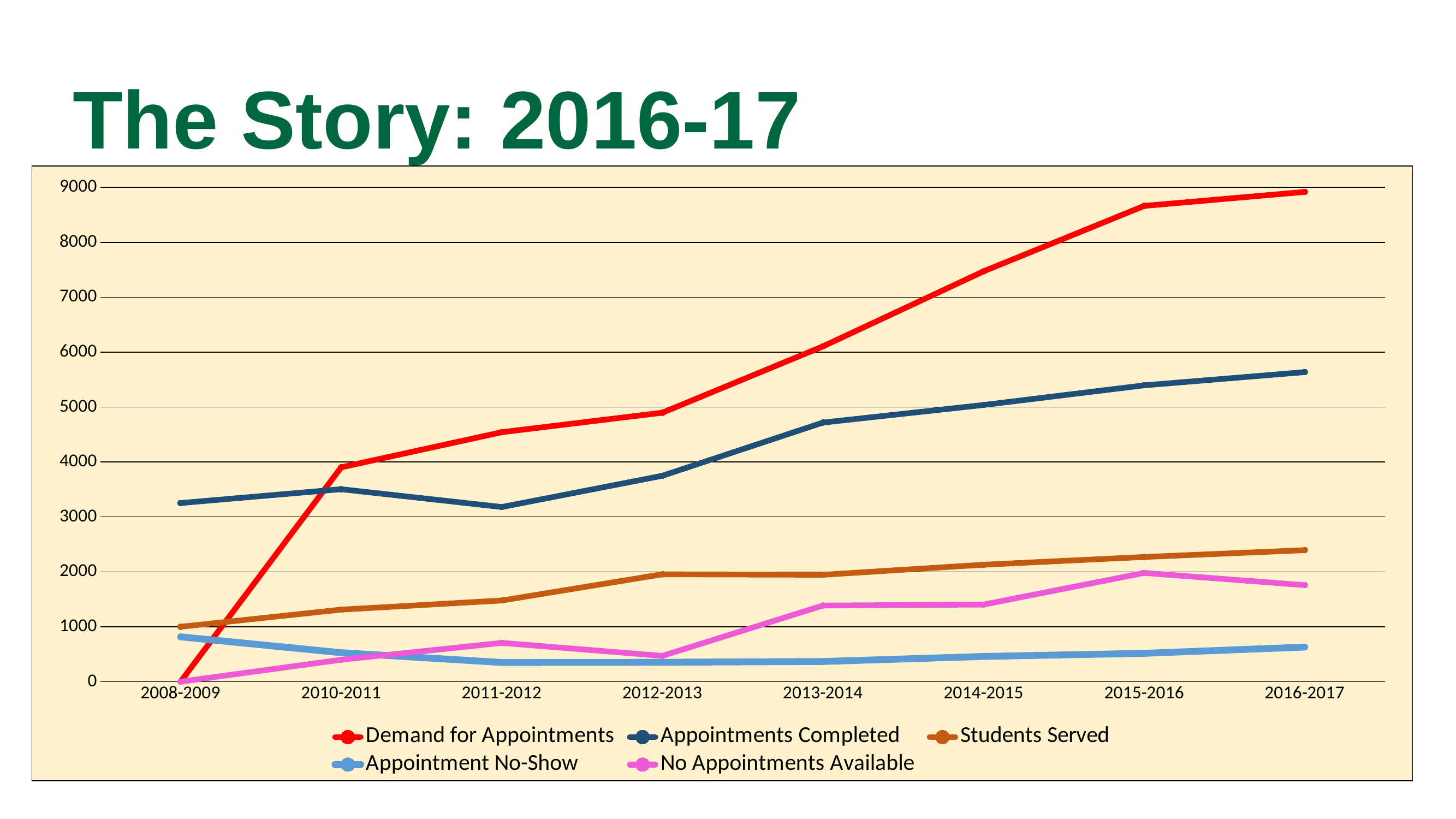
What is the title of the slide? The Story: 2016-17 Does the Demand for Appointments line rise or fall from 2008-2009 to 2016-2017? rise Is the value for Students Served in 2016-2017 greater or less than 2000? greater Is the value for Appointments Completed in 2016-2017 greater or less than 6000? less Is the value for Demand for Appointments in 2016-2017 greater or less than 8000? greater Which series has the highest value in 2016-2017? Demand for Appointments In 2015-2016, which is larger: No Appointments Available or Appointment No-Show? No Appointments Available Which series has the lowest value in 2016-2017? Appointment No-Show What kind of chart is shown on the slide? line chart How many series does the legend list? 5 How many academic years are shown on the x axis? 8 In 2010-2011, which is larger: Demand for Appointments or Appointments Completed? Demand for Appointments